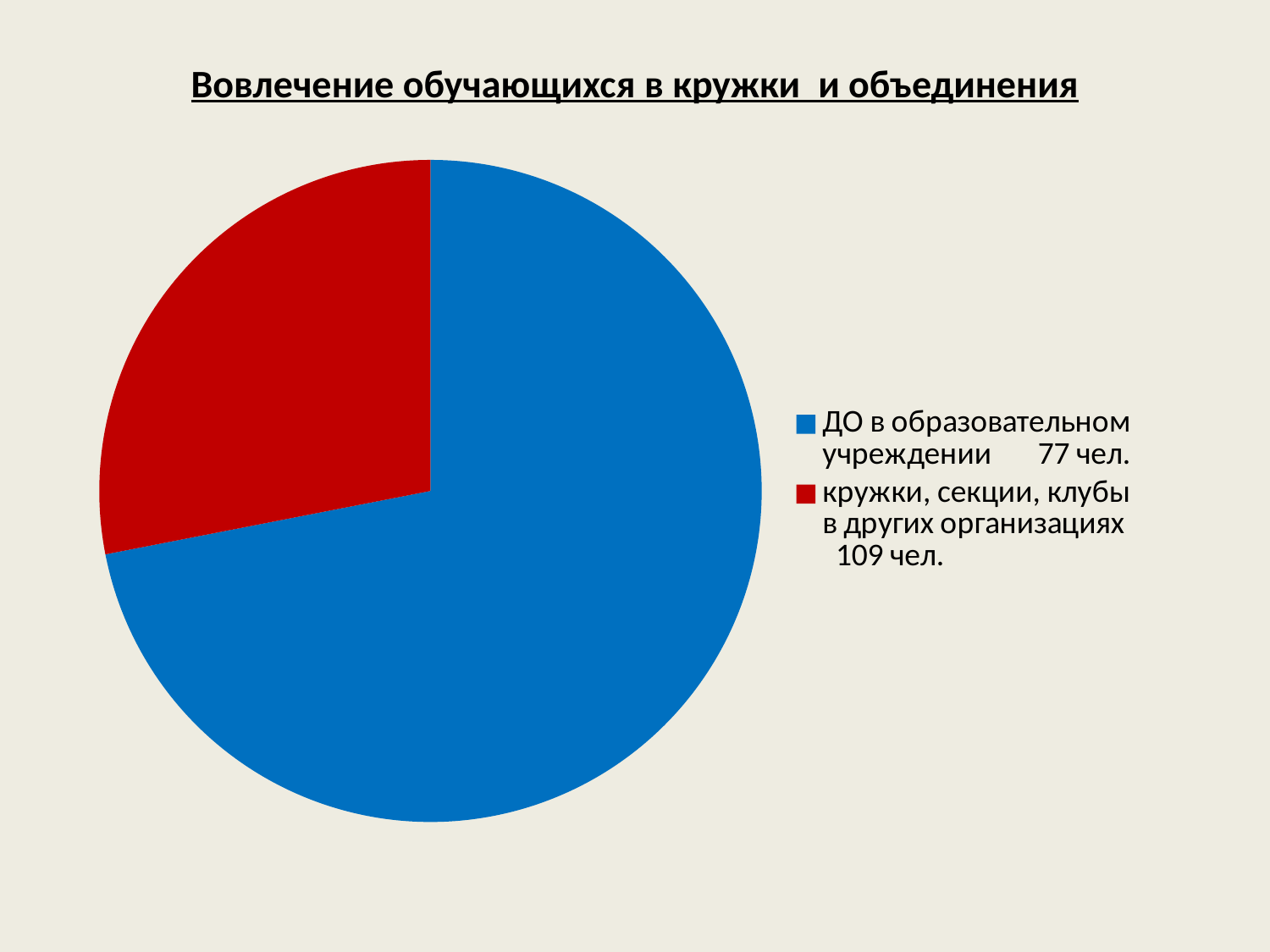
Which colour represents "ДО в образовательном учреждении" in the legend? blue What kind of chart is shown on the slide? pie chart How many people are listed in the legend for "кружки, секции, клубы в других организациях"? 109 чел. What is the difference between the number of people listed for "кружки, секции, клубы в других организациях" and for "ДО в образовательном учреждении"? 32 чел. How many slices does the pie chart have? 2 What is the title of the chart? Вовлечение обучающихся в кружки и объединения How many people are listed in the legend for "ДО в образовательном учреждении"? 77 чел. How many entries does the legend list? 2